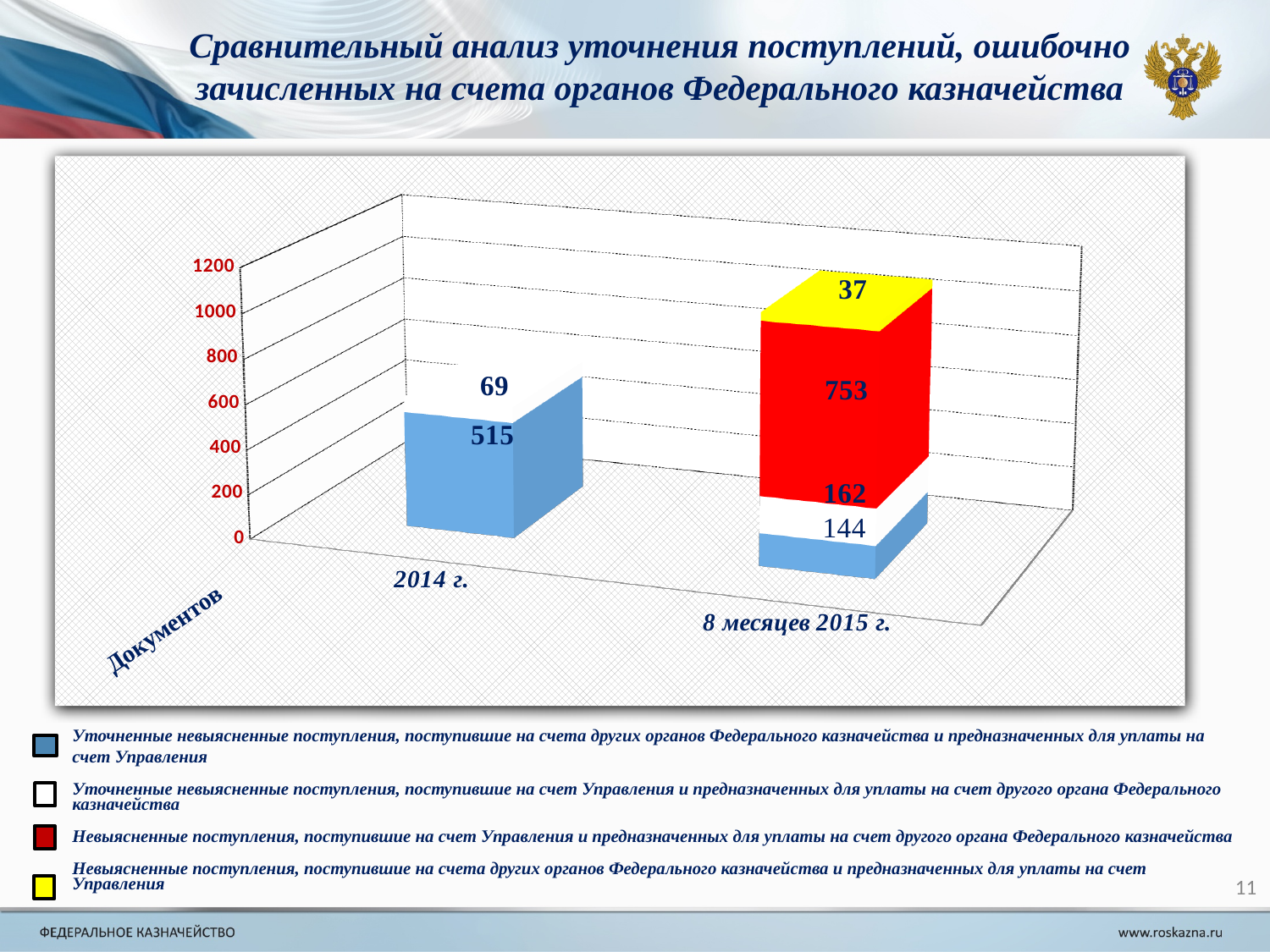
How many categories are shown on the x axis of the chart? 2 What is the value of the blue segment for "2014 г."? 515 Which is larger: the red segment for "8 месяцев 2015 г." or the blue segment for "2014 г."? the red segment for 8 месяцев 2015 г. What is the value of the red segment (Невыясненные поступления, поступившие на счет Управления...) for "8 месяцев 2015 г."? 753 What is the total of the stacked bar for "8 месяцев 2015 г."? 1096 What is the value of the yellow segment for "8 месяцев 2015 г."? 37 What kind of chart is shown on the slide? bar chart What is the value of the blue segment for "8 месяцев 2015 г."? 144 How many series does the legend list? 4 What is the total of the stacked bar for "2014 г."? 584 What is the difference between the blue segment for "2014 г." and the blue segment for "8 месяцев 2015 г."? 371 What is the value of the white segment for "8 месяцев 2015 г."? 162